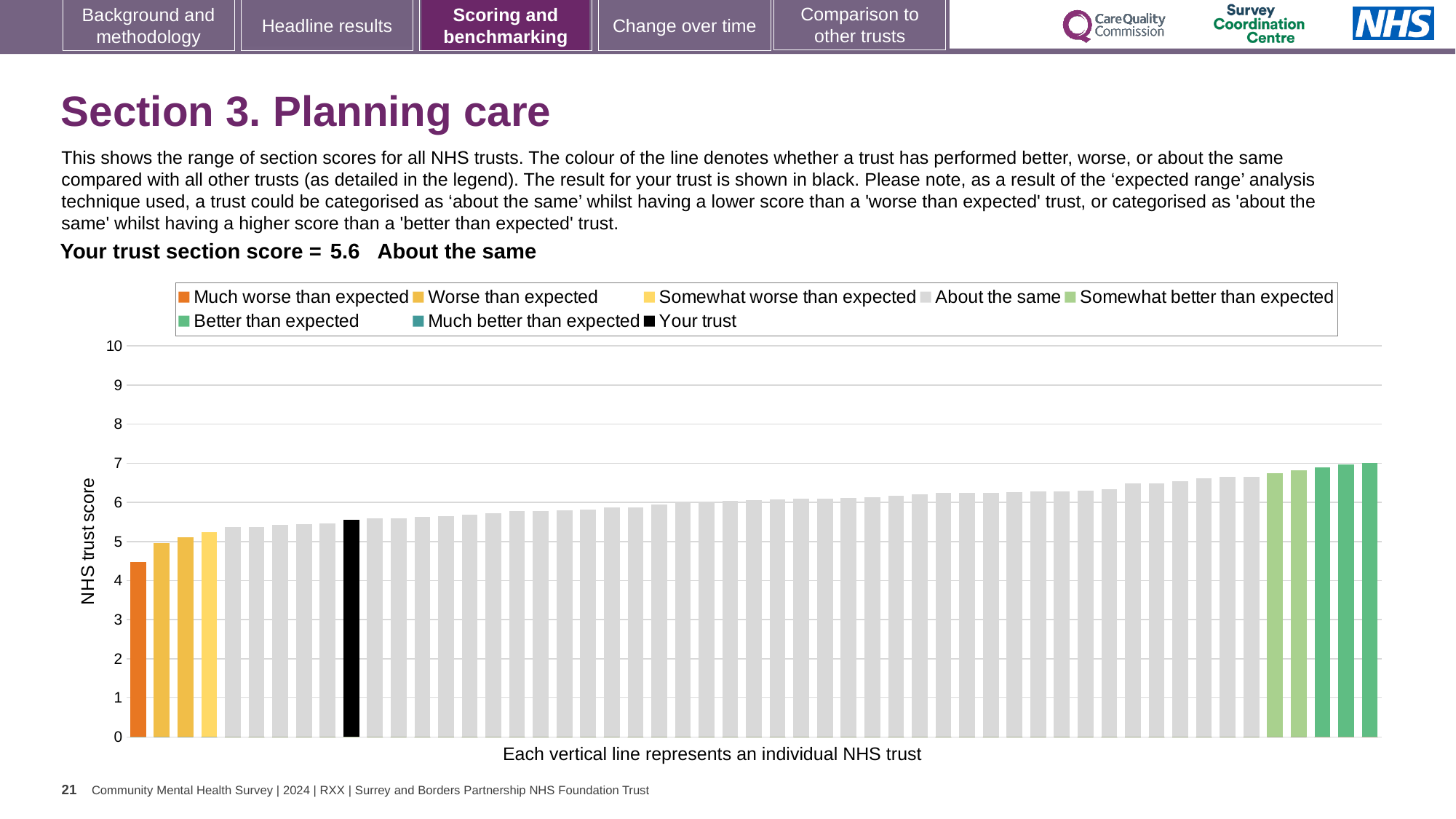
Do the trust scores rise or fall from left to right along the x axis? rise What colour is the bar representing your trust? black Which category is your trust placed in for this section? About the same Is the value for your trust greater or less than 5? greater Is the value for the lowest-scoring trust (the orange bar) greater or less than 5? less Which is larger: the score for the rightmost trust or the score for your trust? the rightmost trust What is the section score for your trust shown on the slide? 5.6 Is the value for the highest-scoring trust greater or less than 6? greater How many entries does the chart legend list? 8 How many bars are coloured orange for 'Much worse than expected'? 1 What kind of chart is shown on the slide? bar chart Which is larger: the score for your trust or the score for the orange 'Much worse than expected' trust? your trust